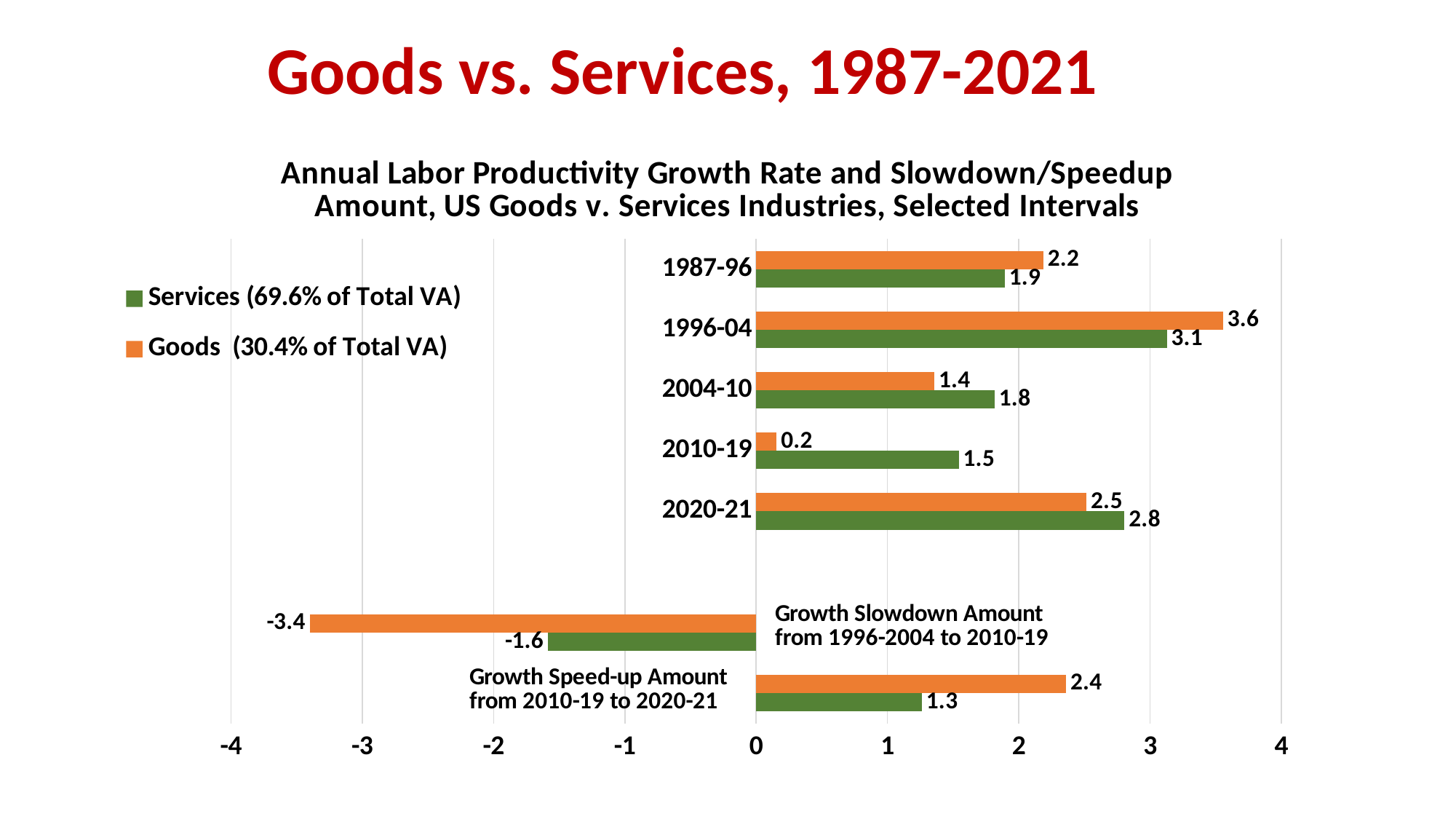
What is the Goods value for the Growth Slowdown Amount from 1996-2004 to 2010-19? -3.4 What is the Services value for the Growth Speed-up Amount from 2010-19 to 2020-21? 1.3 In which interval is the Goods growth rate highest? 1996-04 Which is larger for 2004-10, the Goods value or the Services value? Services What is the difference between the Goods and Services values for 2010-19? 1.3 How many series does the legend list? 2 What share of Total VA does the legend give for Services? 69.6% What kind of chart is shown? Bar chart In which interval is the Goods growth rate lowest? 2010-19 What is the Services value for 2010-19? 1.5 Which colour represents Goods in the chart? Orange What is the Goods value for 1996-04? 3.6